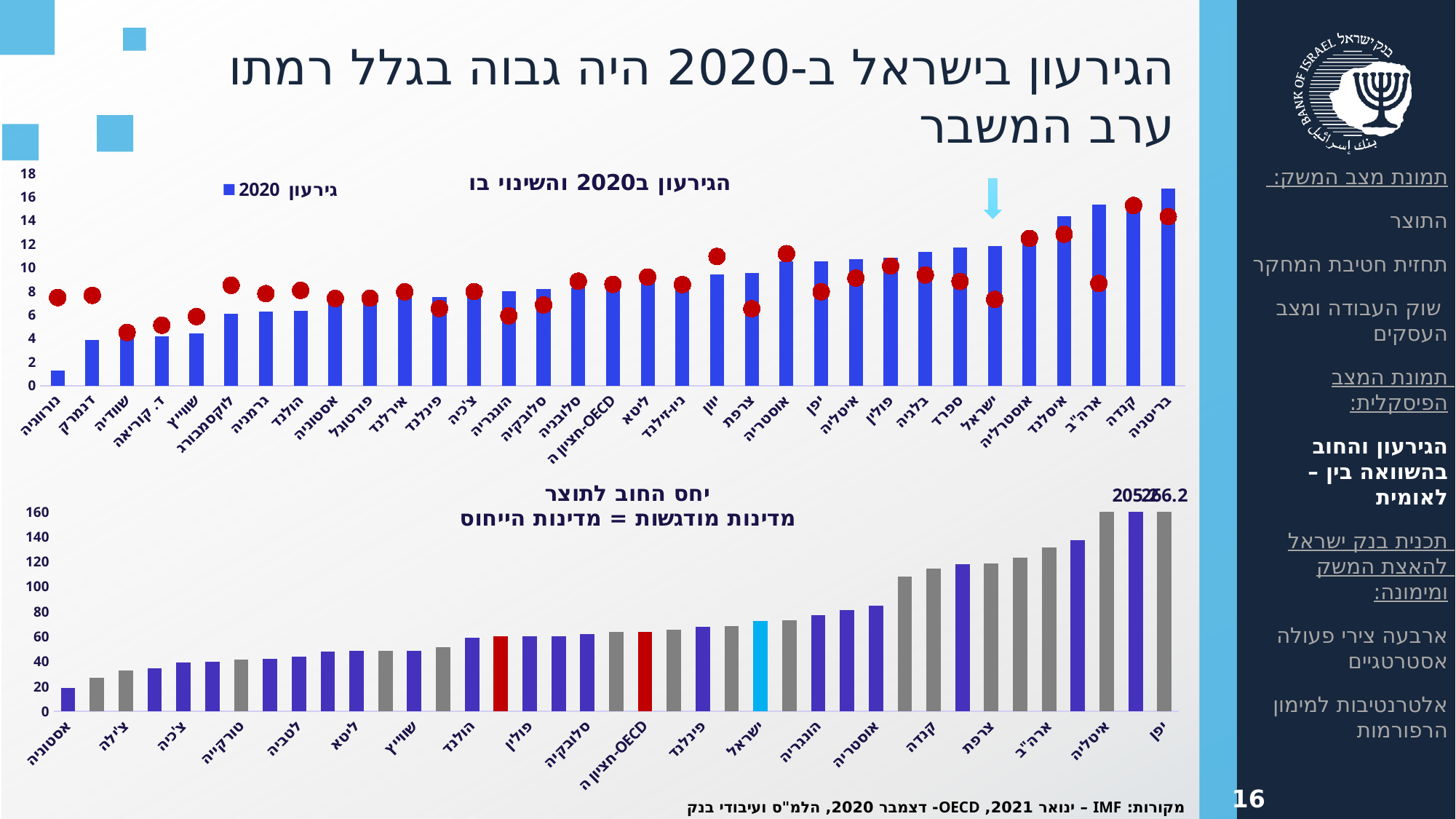
In the bottom chart "יחס החוב לתוצר", which country has the highest debt-to-GDP ratio? יפן In the top chart "הגירעון ב2020 והשינוי בו", is the bar for בריטניה greater or less than 14? greater In the bottom chart "יחס החוב לתוצר", is the bar for ישראל greater or less than 60? greater In the top chart "הגירעון ב2020 והשינוי בו", is the bar for ישראל greater or less than 10? greater In the bottom chart "יחס החוב לתוצר", what value is labeled for יפן? 266.2 In the bottom chart "יחס החוב לתוצר", which is larger: the bar for ישראל or the bar for OECD-חציון? ישראל In the top chart "הגירעון ב2020 והשינוי בו", which country has the shortest bar? נורווגיה How many series does the legend of the top chart "הגירעון ב2020 והשינוי בו" list? 1 In the top chart "הגירעון ב2020 והשינוי בו", which country has the tallest bar? בריטניה What kind of chart is the bottom chart titled "יחס החוב לתוצר"? bar chart In the bottom chart "יחס החוב לתוצר", do the bars rise or fall from left to right? rise